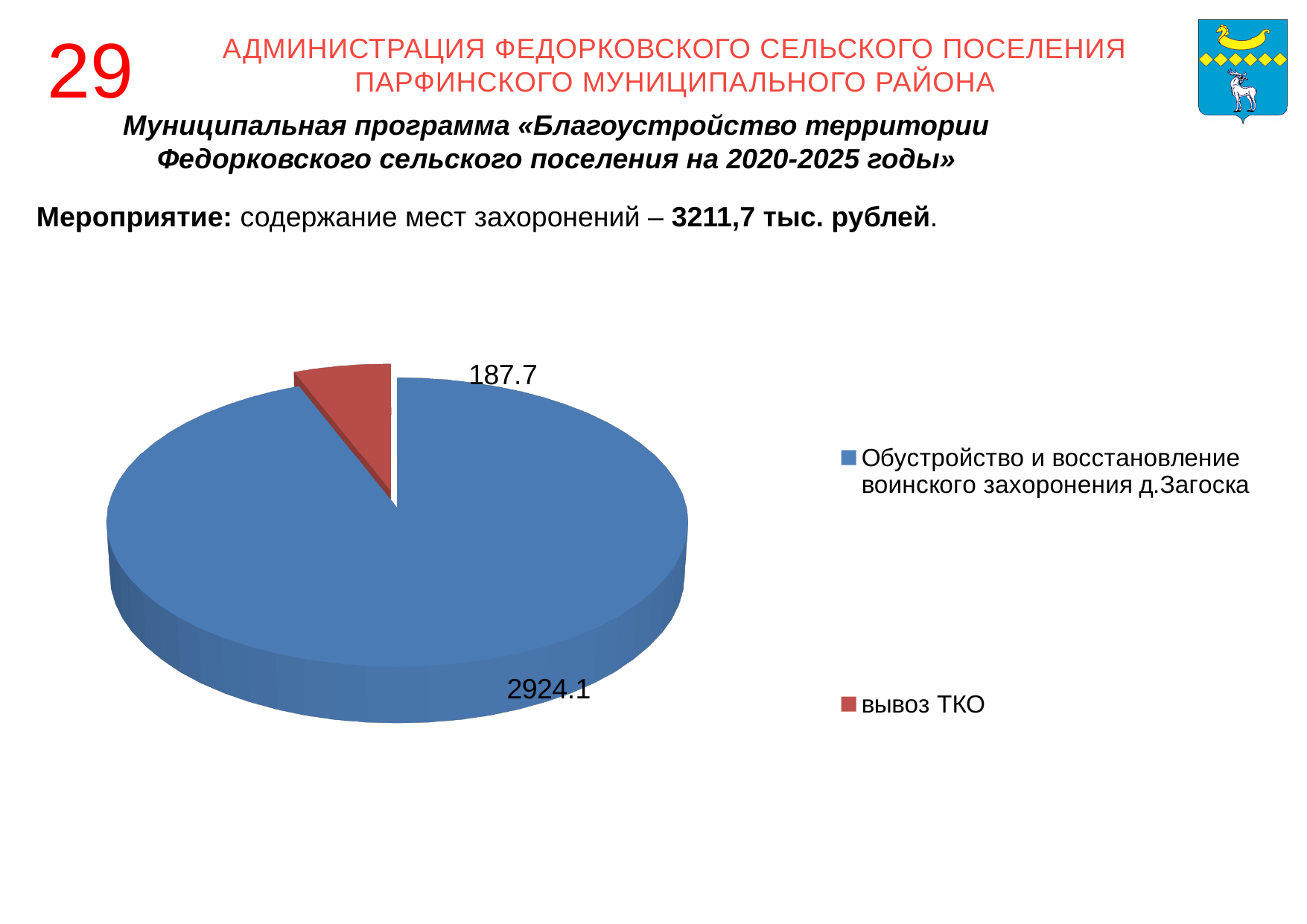
Which category has the smallest slice in the pie chart? вывоз ТКО What is the difference between the value for "Обустройство и восстановление воинского захоронения д.Загоска" and the value for "вывоз ТКО"? 2736.4 Which category has the largest slice in the pie chart? Обустройство и восстановление воинского захоронения д.Загоска What colour is the slice for "Обустройство и восстановление воинского захоронения д.Загоска" in the pie chart? blue How many entries does the legend of the pie chart list? 2 Which is larger: the value for "вывоз ТКО" or the value for "Обустройство и восстановление воинского захоронения д.Загоска"? Обустройство и восстановление воинского захоронения д.Загоска What is the value for "вывоз ТКО" in the pie chart? 187.7 What colour is the slice for "вывоз ТКО" in the pie chart? red How many slices does the pie chart have? 2 What kind of chart is shown on the slide? pie chart What is the value for "Обустройство и восстановление воинского захоронения д.Загоска" in the pie chart? 2924.1 What is the total of the two values shown in the pie chart? 3111.8